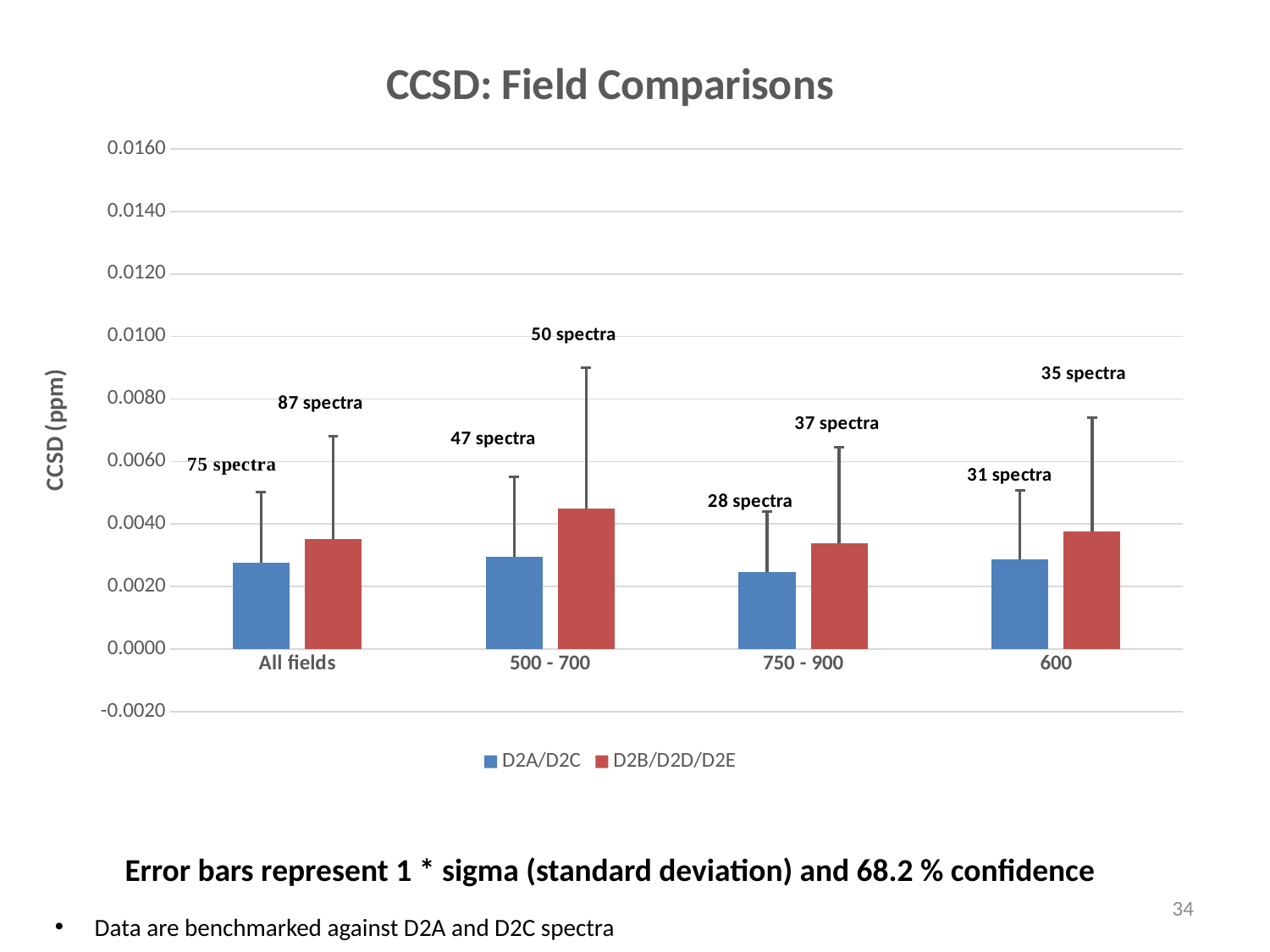
How many spectra are annotated above the D2B/D2D/D2E bar in the 500 - 700 category? 50 spectra Is the D2A/D2C value for 750 - 900 greater or less than 0.0040? less Which category has the lowest value for the D2A/D2C series? 750 - 900 In the 500 - 700 category, which series has the larger value, D2A/D2C or D2B/D2D/D2E? D2B/D2D/D2E Is the D2A/D2C value for All fields greater or less than 0.0020? greater How many series does the legend list? 2 Which category has the highest value for the D2B/D2D/D2E series? 500 - 700 Is the D2B/D2D/D2E value for 500 - 700 greater or less than 0.0040? greater What is the title of the chart? CCSD: Field Comparisons What kind of chart is shown on the slide? bar chart In the All fields category, which series has the larger value, D2A/D2C or D2B/D2D/D2E? D2B/D2D/D2E How many categories are shown on the x axis? 4